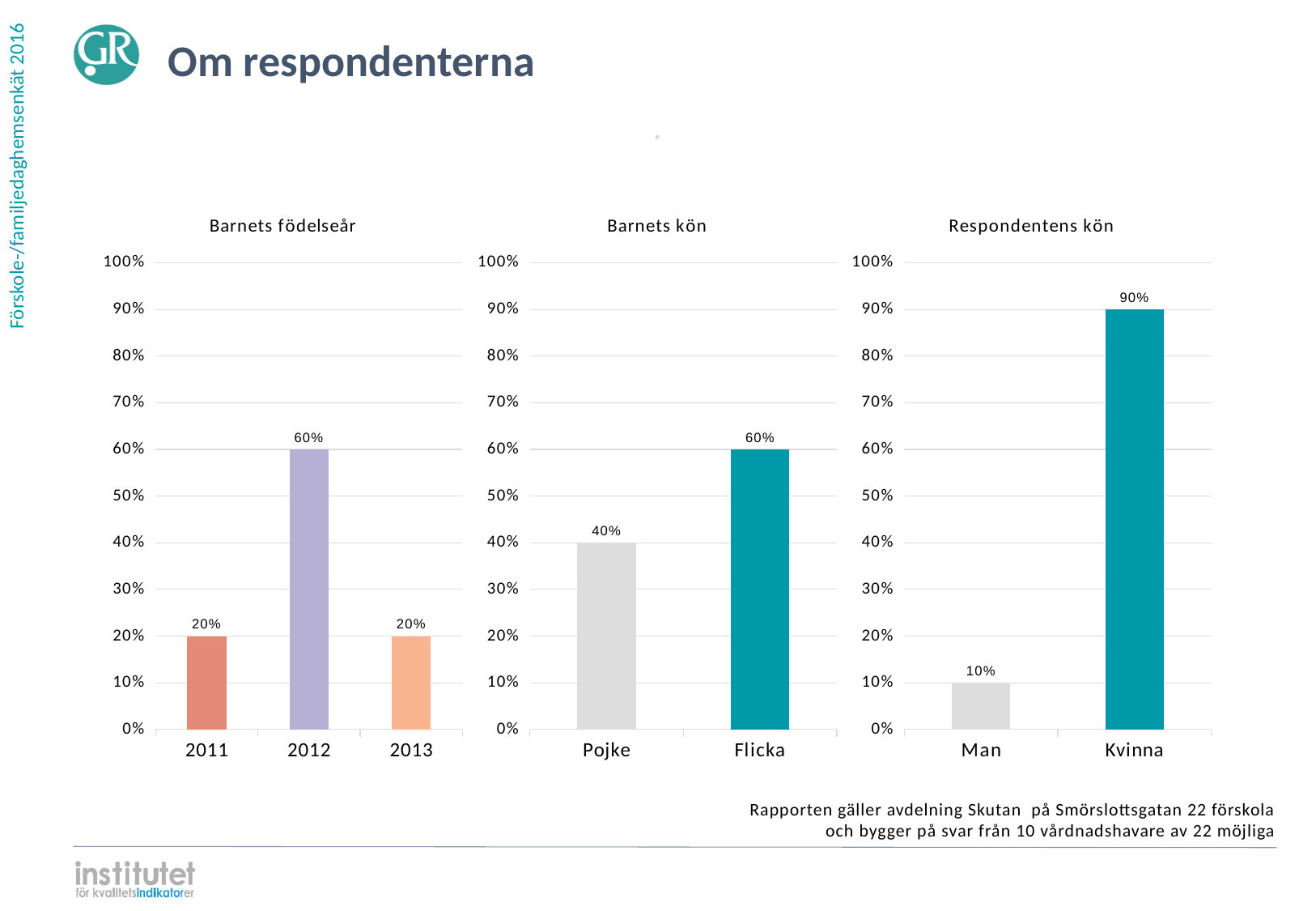
In the 'Barnets kön' chart, what is the value for Pojke? 40% In the 'Respondentens kön' chart, which category has the lowest value? Man In the 'Respondentens kön' chart, what is the difference between Kvinna and Man? 80% In the 'Barnets födelseår' chart, what is the value for 2012? 60% In the 'Barnets kön' chart, what is the difference between Flicka and Pojke? 20% In the 'Barnets kön' chart, which category is larger, Pojke or Flicka? Flicka In the 'Barnets födelseår' chart, how many birth years are shown? 3 In the 'Barnets födelseår' chart, what is the difference between the values for 2012 and 2011? 40% How many charts are shown on the slide? 3 In the 'Barnets födelseår' chart, which birth year has the highest value? 2012 In the 'Respondentens kön' chart, what is the value for Kvinna? 90% What kind of chart is the 'Respondentens kön' chart? Bar chart